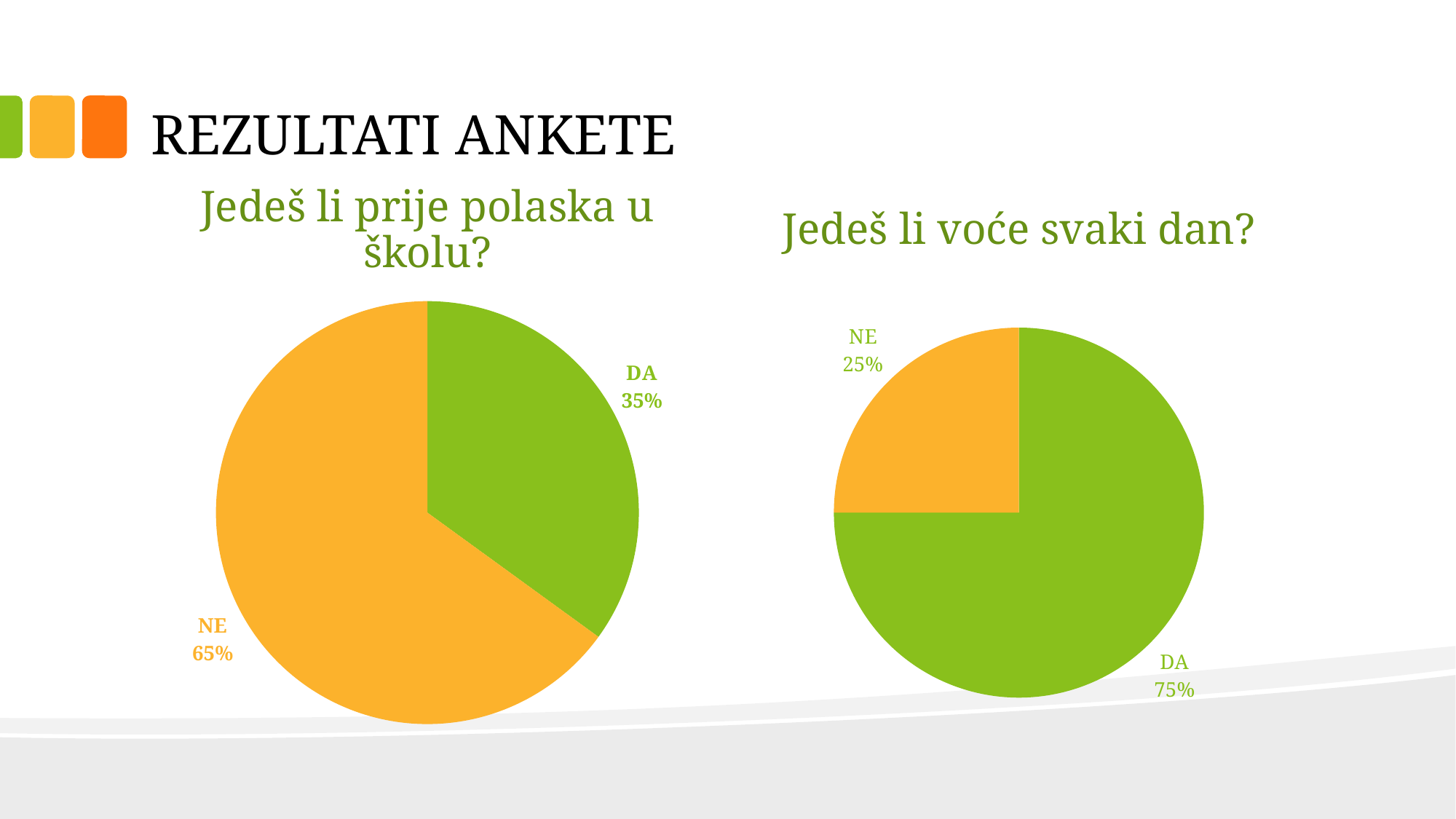
In the chart titled "Jedeš li voće svaki dan?", what is the value for DA? 75% In the chart titled "Jedeš li voće svaki dan?", which category has the smallest share? NE In the chart titled "Jedeš li voće svaki dan?", which is larger, DA or NE? DA In the chart titled "Jedeš li prije polaska u školu?", what colour is the DA slice? Green In the chart titled "Jedeš li prije polaska u školu?", what is the value for DA? 35% How many slices does the chart titled "Jedeš li voće svaki dan?" have? 2 In the chart titled "Jedeš li prije polaska u školu?", which category has the largest share? NE In the chart titled "Jedeš li voće svaki dan?", what is the difference between DA and NE? 50% In the chart titled "Jedeš li prije polaska u školu?", what is the difference between NE and DA? 30% In the chart titled "Jedeš li voće svaki dan?", what is the value for NE? 25% What kind of chart is the chart on the left of the slide? Pie chart In the chart titled "Jedeš li prije polaska u školu?", what is the value for NE? 65%